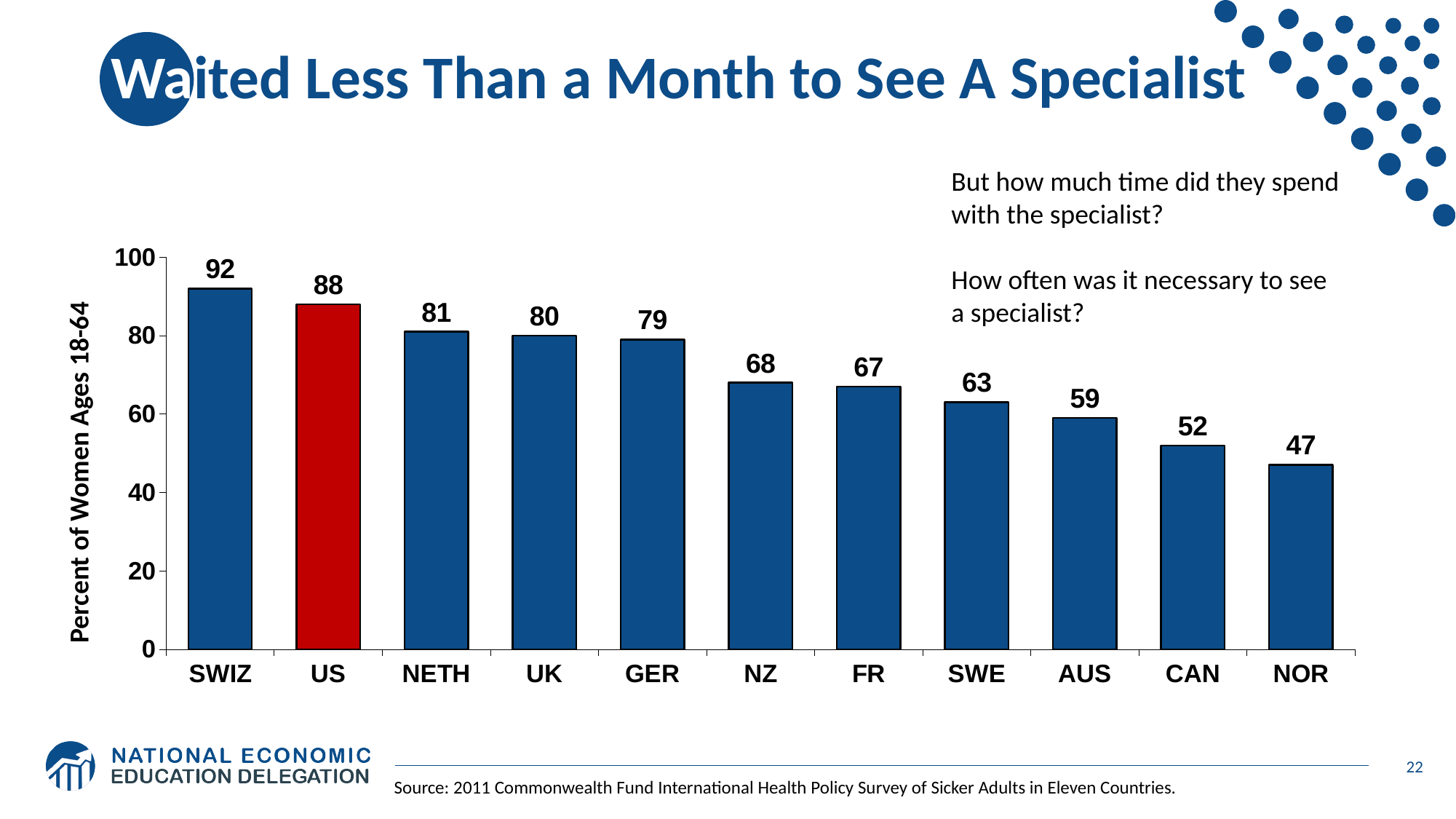
What kind of chart is shown on the slide? bar chart How many countries are shown on the x axis? 11 What is the value for NOR? 47 Which country's bar is coloured red? US Is the value for AUS greater or less than 60? less Which country has the lowest value? NOR What is the difference between the values for SWIZ and the US? 4 What is the value for GER? 79 Which is larger, the value for NZ or the value for SWE? NZ What is the difference between the values for NETH and CAN? 29 What is the value for the US? 88 Which country has the highest value? SWIZ